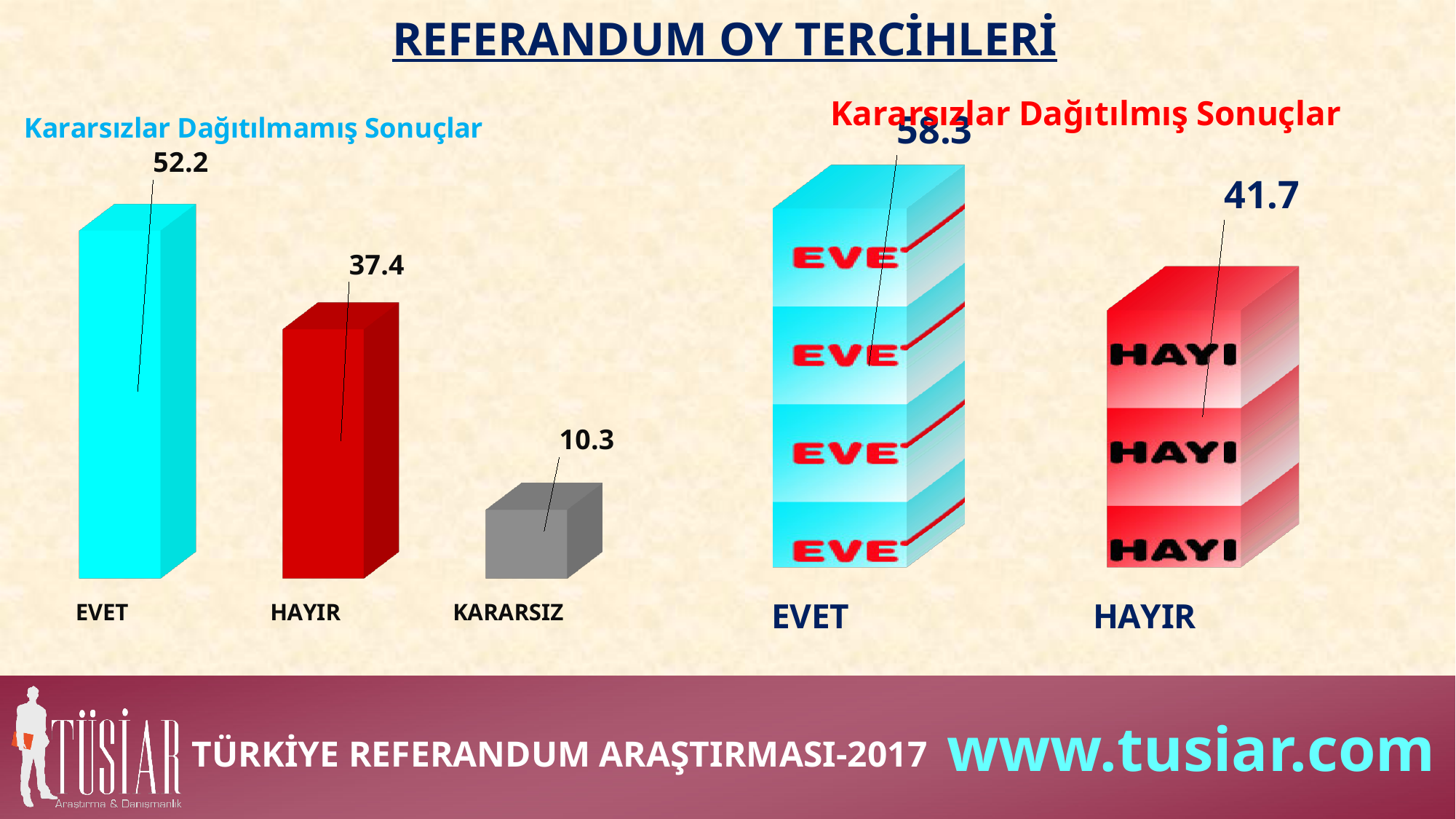
In the right chart (Kararsızlar Dağıtılmış Sonuçlar), which is larger, EVET or HAYIR? EVET In the right chart (Kararsızlar Dağıtılmış Sonuçlar), what is the value for HAYIR? 41.7 In the left chart (Kararsızlar Dağıtılmamış Sonuçlar), what is the value for KARARSIZ? 10.3 In the left chart (Kararsızlar Dağıtılmamış Sonuçlar), what is the value for HAYIR? 37.4 In the right chart (Kararsızlar Dağıtılmış Sonuçlar), what is the value for EVET? 58.3 In the left chart (Kararsızlar Dağıtılmamış Sonuçlar), which category has the highest value? EVET In the right chart (Kararsızlar Dağıtılmış Sonuçlar), what is the difference between the EVET and HAYIR values? 16.6 In the left chart (Kararsızlar Dağıtılmamış Sonuçlar), what is the difference between the EVET and HAYIR values? 14.8 How many categories are shown in the left chart (Kararsızlar Dağıtılmamış Sonuçlar)? 3 In the left chart (Kararsızlar Dağıtılmamış Sonuçlar), what is the value for EVET? 52.2 In the left chart (Kararsızlar Dağıtılmamış Sonuçlar), which category has the lowest value? KARARSIZ What type of chart is the left chart (Kararsızlar Dağıtılmamış Sonuçlar)? Bar chart